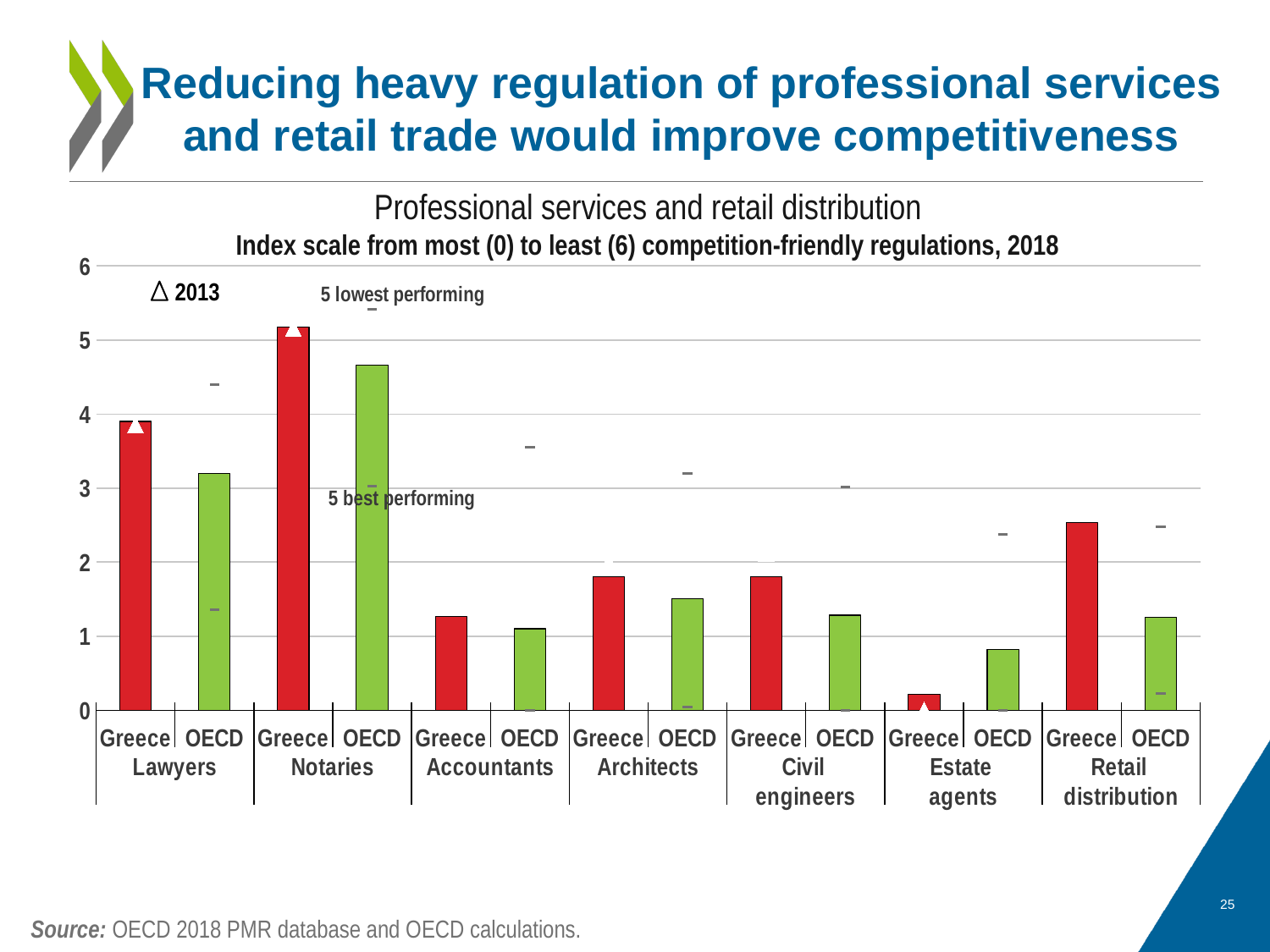
Is the value for Greece in Notaries greater or less than 4? greater For Estate agents, which is larger: Greece or OECD? OECD Is the value for OECD in Lawyers greater or less than 4? less Is the value for Greece in Lawyers greater or less than 3? greater Which bar is the lowest in the chart? Greece, Estate agents What year does the triangle marker in the chart represent? 2013 How many sectors are shown along the x axis? 7 What kind of chart is shown on the slide? bar chart For Retail distribution, which is larger: Greece or OECD? Greece Which bar is the highest in the chart? Greece, Notaries